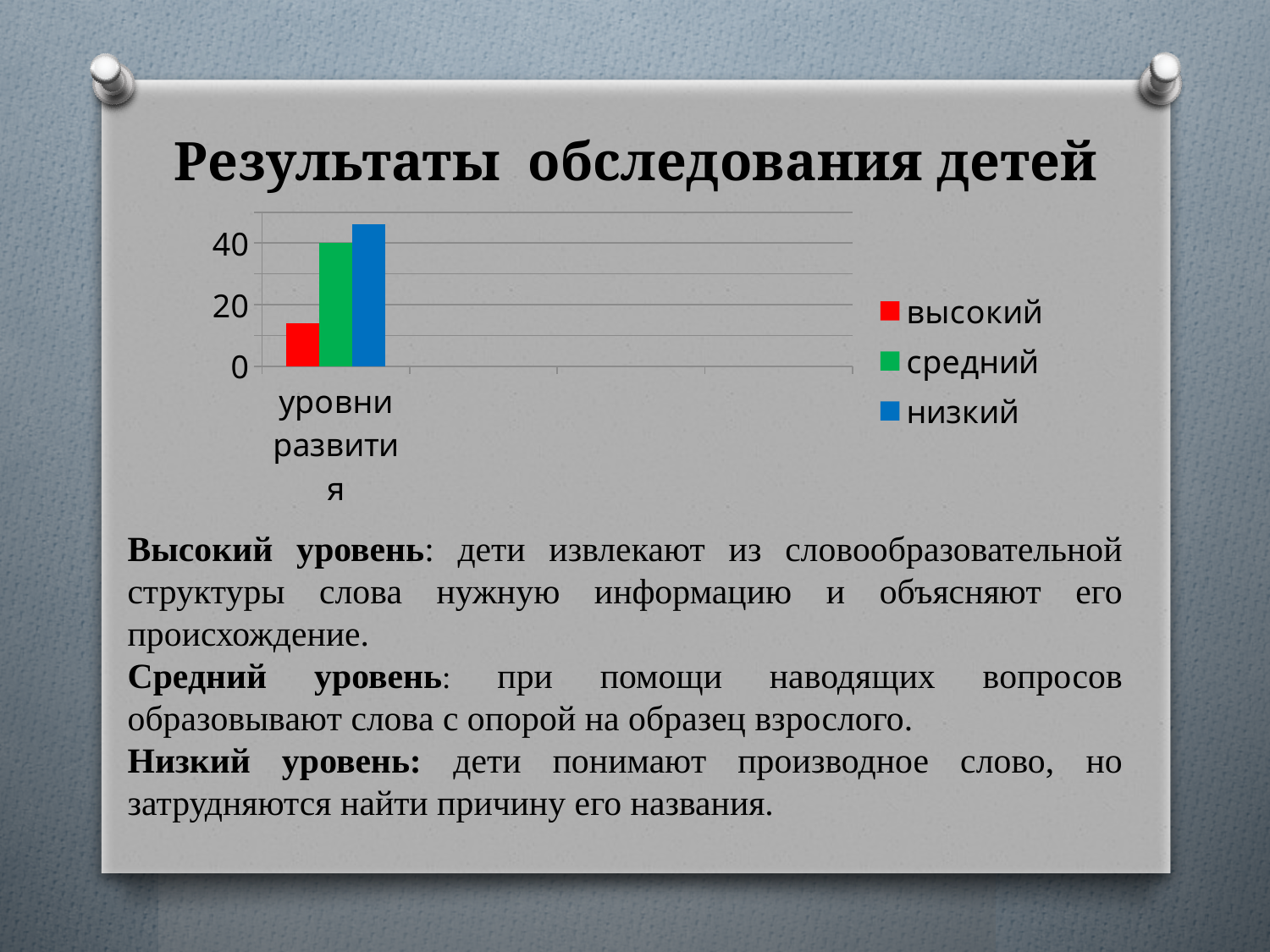
How many categories are shown on the x axis of the chart? 1 What is the category label shown on the x axis of the chart? уровни развития How many series does the chart legend list? 3 Which series has the highest bar in the chart? низкий What colour is the bar for the series средний? green Is the value for средний greater or less than 20? greater What kind of chart is shown on the slide? bar chart Which is larger, the value for средний or the value for высокий? средний Which series has the lowest bar in the chart? высокий Is the value for низкий greater or less than 40? greater Is the value for высокий greater or less than 20? less Which is larger, the value for низкий or the value for высокий? низкий